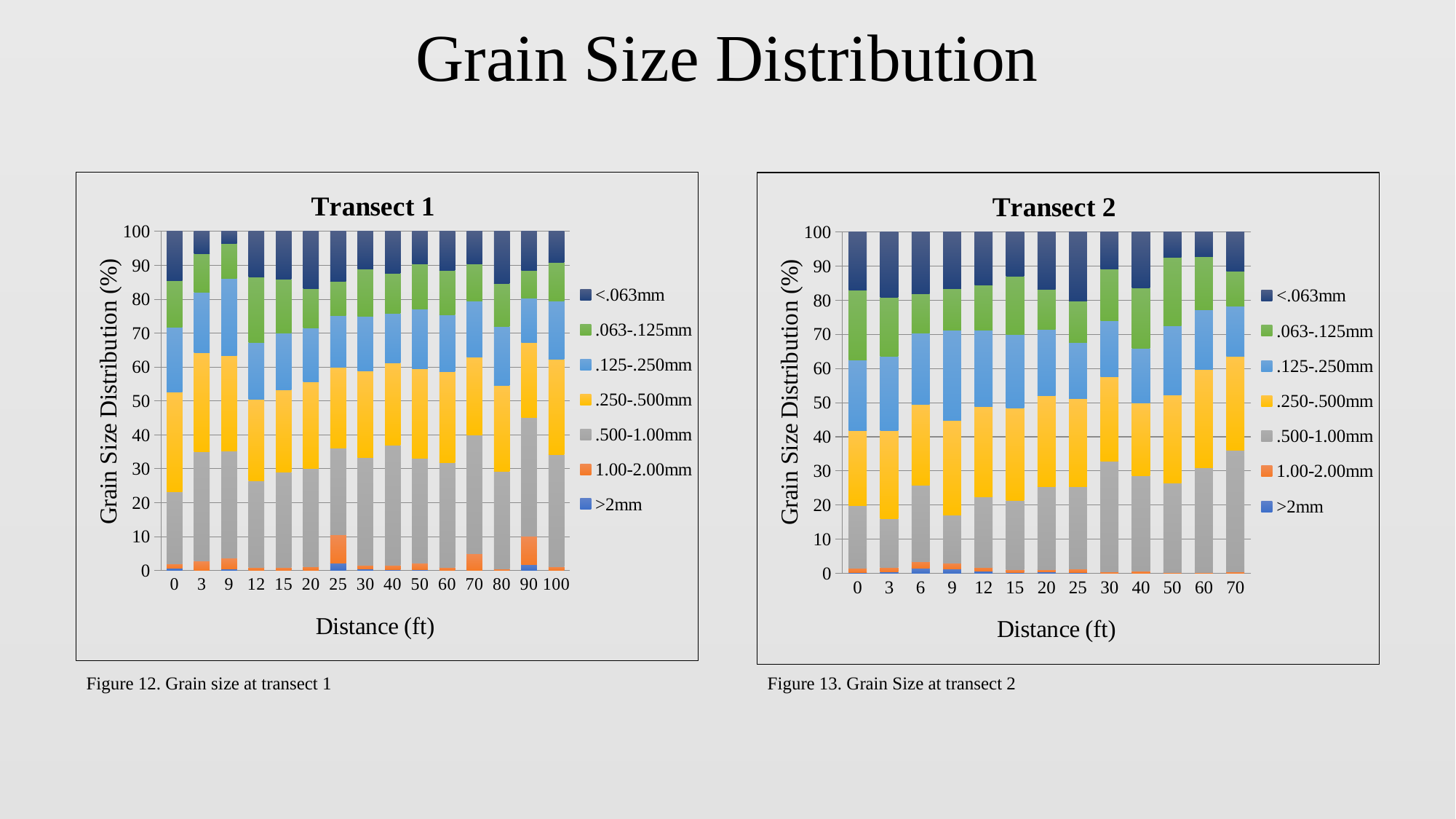
How many distance categories are shown on the x axis of the Transect 2 chart? 13 In the Transect 1 chart, is the top of the .250-.500mm segment at 90 ft greater or less than 60? greater What is the x-axis label on the Transect 2 chart? Distance (ft) What is the y-axis label on the Transect 1 chart? Grain Size Distribution (%) In the Transect 1 chart, at which distance is the <.063mm segment smallest? 9 How many distance categories are shown on the x axis of the Transect 1 chart? 15 In the Transect 2 chart, what is the total height of each stacked bar? 100 In the Transect 2 chart, is the top of the .250-.500mm segment at 70 ft greater or less than 60? greater In the Transect 2 chart, is the top of the .500-1.00mm segment at 3 ft greater or less than 20? less What kind of chart is the Transect 1 chart? Stacked bar chart In the Transect 1 chart, is the .500-1.00mm segment larger at 0 ft or at 3 ft? 3 ft How many series does the legend of the Transect 2 chart list? 7